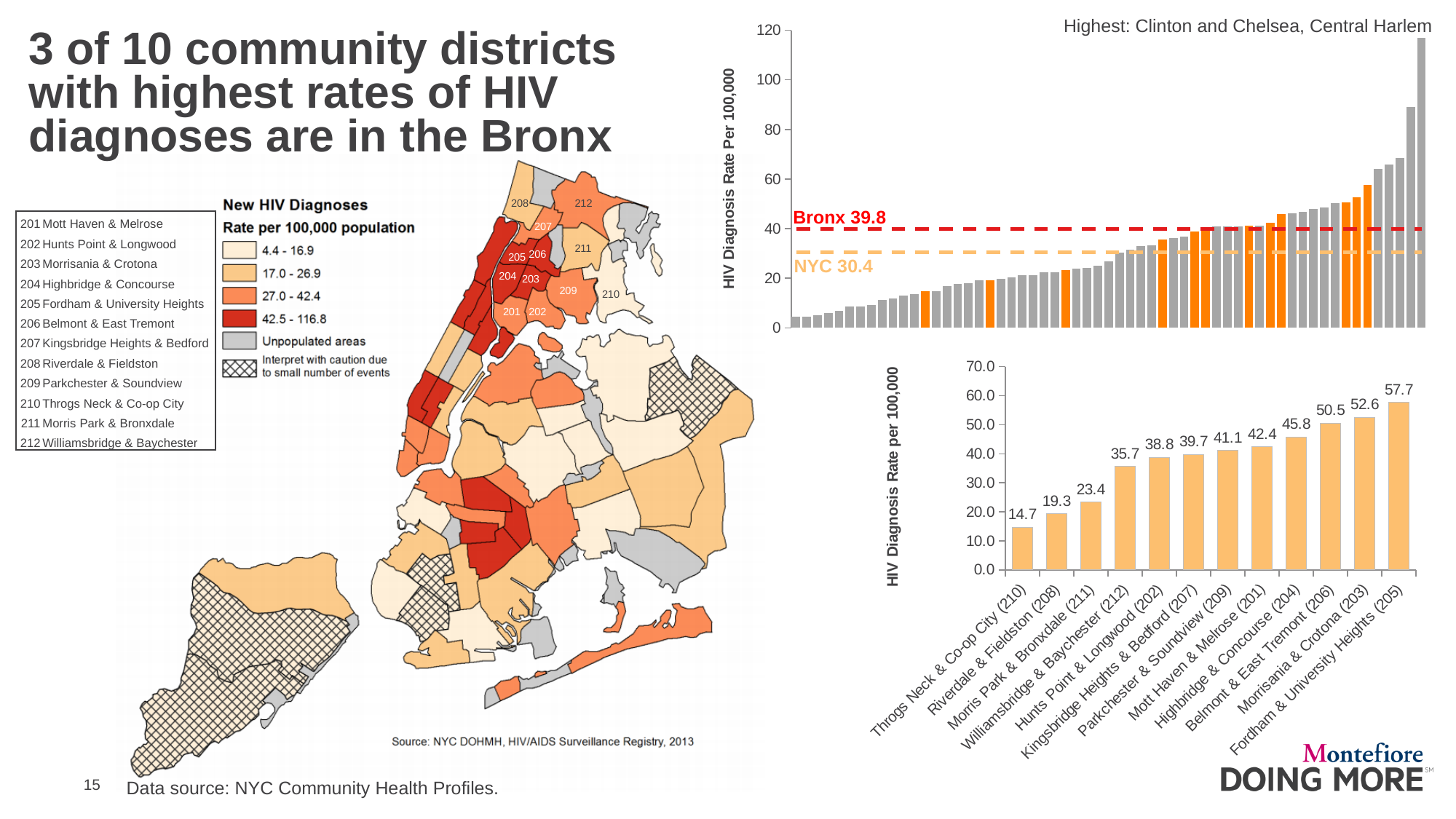
In the bottom-right bar chart, which has the higher rate: Morrisania & Crotona (203) or Belmont & East Tremont (206)? Morrisania & Crotona (203) In the bottom-right bar chart, what is the HIV diagnosis rate per 100,000 for Fordham & University Heights (205)? 57.7 In the bottom-right bar chart, what is the difference between the rates for Fordham & University Heights (205) and Throgs Neck & Co-op City (210)? 43.0 In the bottom-right bar chart, how many community districts are plotted? 12 In the top-right bar chart, what value is marked by the red dashed Bronx reference line? 39.8 In the bottom-right bar chart, what is the value for Hunts Point & Longwood (202)? 38.8 What kind of chart is the bottom-right chart titled 'HIV Diagnosis Rate per 100,000' with district names on the x axis? bar chart In the bottom-right bar chart, do the values rise or fall from left to right along the x axis? rise In the bottom-right bar chart, which community district has the highest HIV diagnosis rate? Fordham & University Heights (205) In the bottom-right bar chart, what is the HIV diagnosis rate per 100,000 for Throgs Neck & Co-op City (210)? 14.7 In the bottom-right bar chart, which community district has the lowest HIV diagnosis rate? Throgs Neck & Co-op City (210) In the top-right bar chart, is the value of the tallest bar greater or less than 100? greater